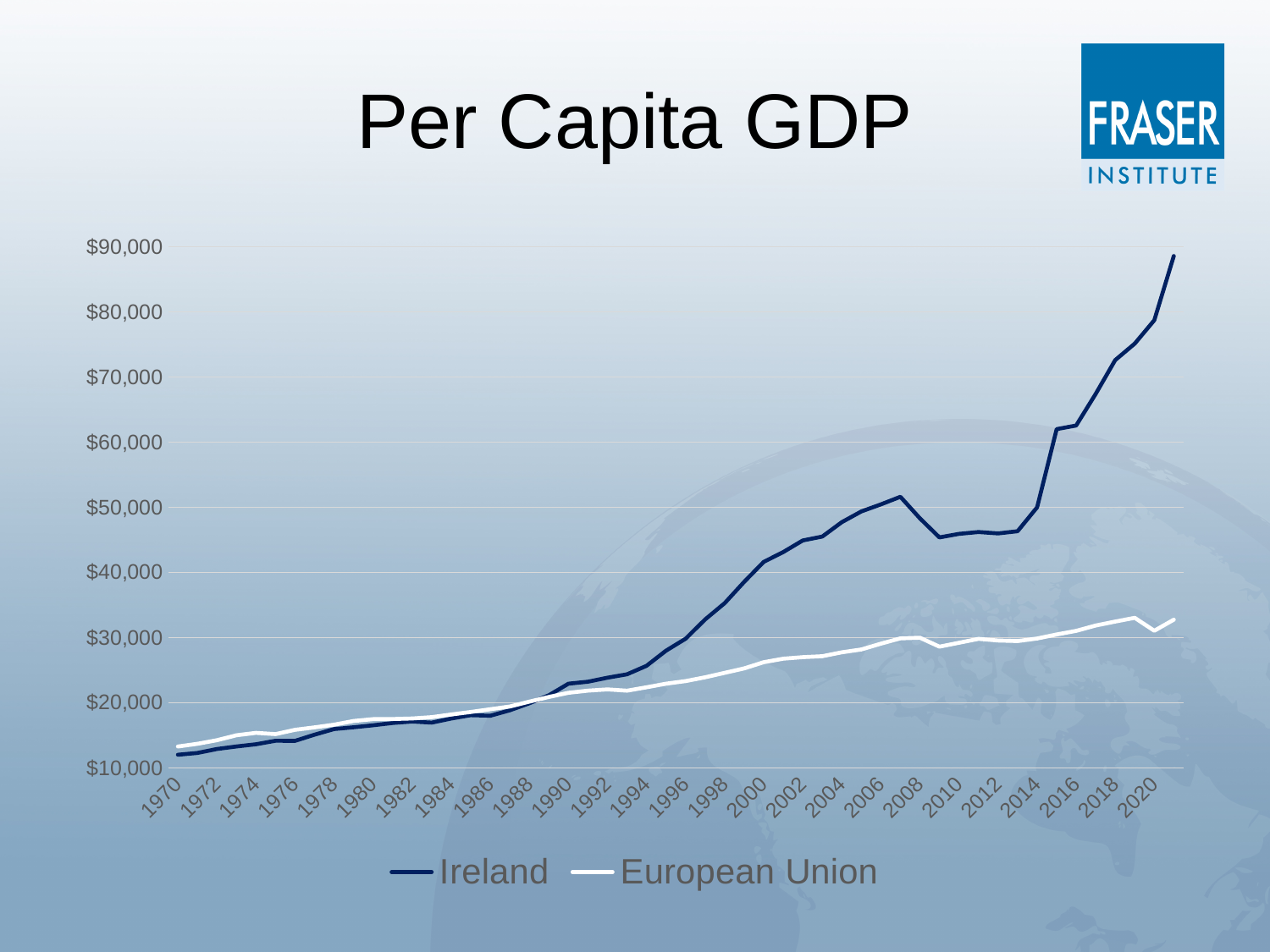
Is the value for the European Union in 2008 greater or less than $20,000? greater How many series does the legend list? 2 Is the value for Ireland in 2007 greater or less than $40,000? greater What kind of chart is shown on the slide? line chart In 1974, which series has the higher value, Ireland or the European Union? European Union Does the Ireland line rise or fall between 2014 and 2020? rise Is the value for Ireland at the final point of the series greater or less than $80,000? greater What is the title of the chart? Per Capita GDP Which series reaches the highest value on the chart? Ireland In 2016, which series has the higher value, Ireland or the European Union? Ireland What are the two series named in the legend? Ireland and European Union